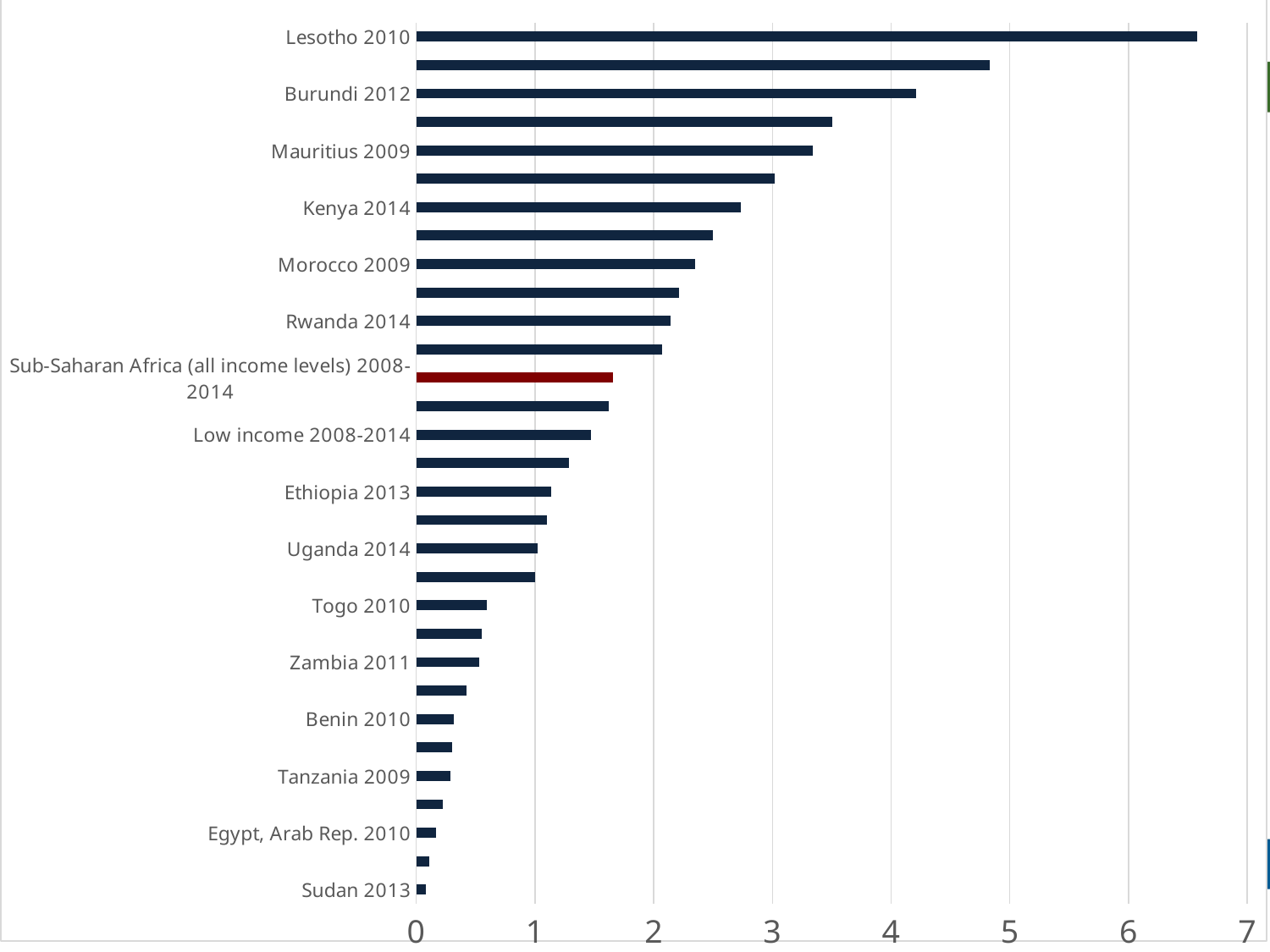
What kind of chart is shown on the slide? Bar chart Is the value for Kenya 2014 greater or less than 3? less Which is larger, the value for Morocco 2009 or the value for Ethiopia 2013? Morocco 2009 Which category has the longest bar? Lesotho 2010 Which labelled category has the shortest bar? Sudan 2013 Which is larger, the value for Burundi 2012 or the value for Mauritius 2009? Burundi 2012 Is the value for Lesotho 2010 greater or less than 6? greater Is the value for Togo 2010 greater or less than 1? less Which category is highlighted with a red bar? Sub-Saharan Africa (all income levels) 2008-2014 Do the bar values increase or decrease going from the top of the chart to the bottom? Decrease